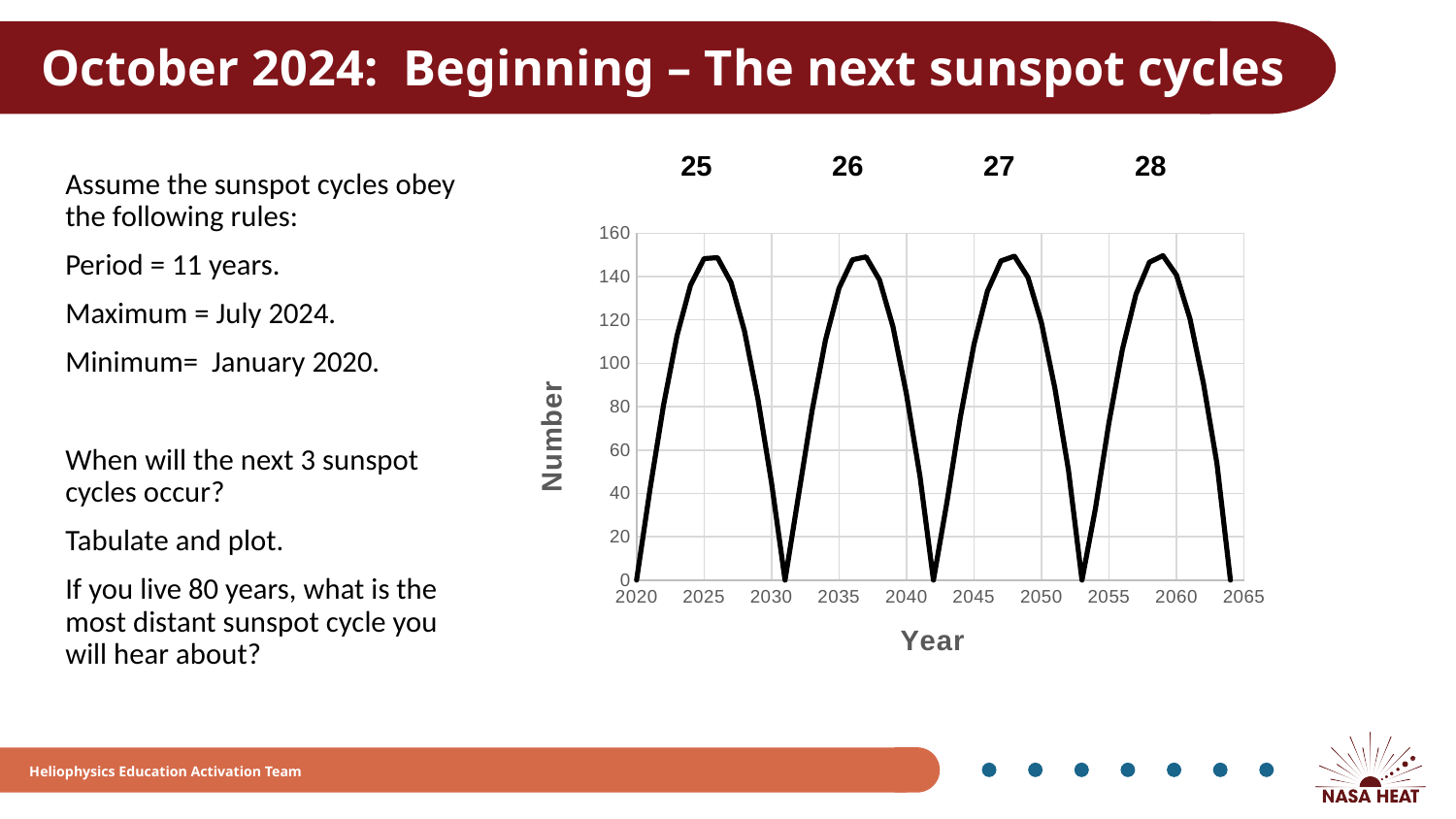
What kind of chart is shown on the slide? line chart Is the peak value of cycle 25 greater or less than 140? greater What is the title of the y axis of the chart? Number Does the line rise or fall between 2025 and 2030? fall What is the title of the x axis of the chart? Year Is the value of the line at the year 2030 greater or less than 80? less Does the line rise or fall between 2020 and 2025? rise Is the peak value of cycle 27 greater or less than 160? less What is the value of the line at the year 2020? 0 How many sunspot cycles are labelled above the chart? 4 What is the lowest value the line reaches on the chart? 0